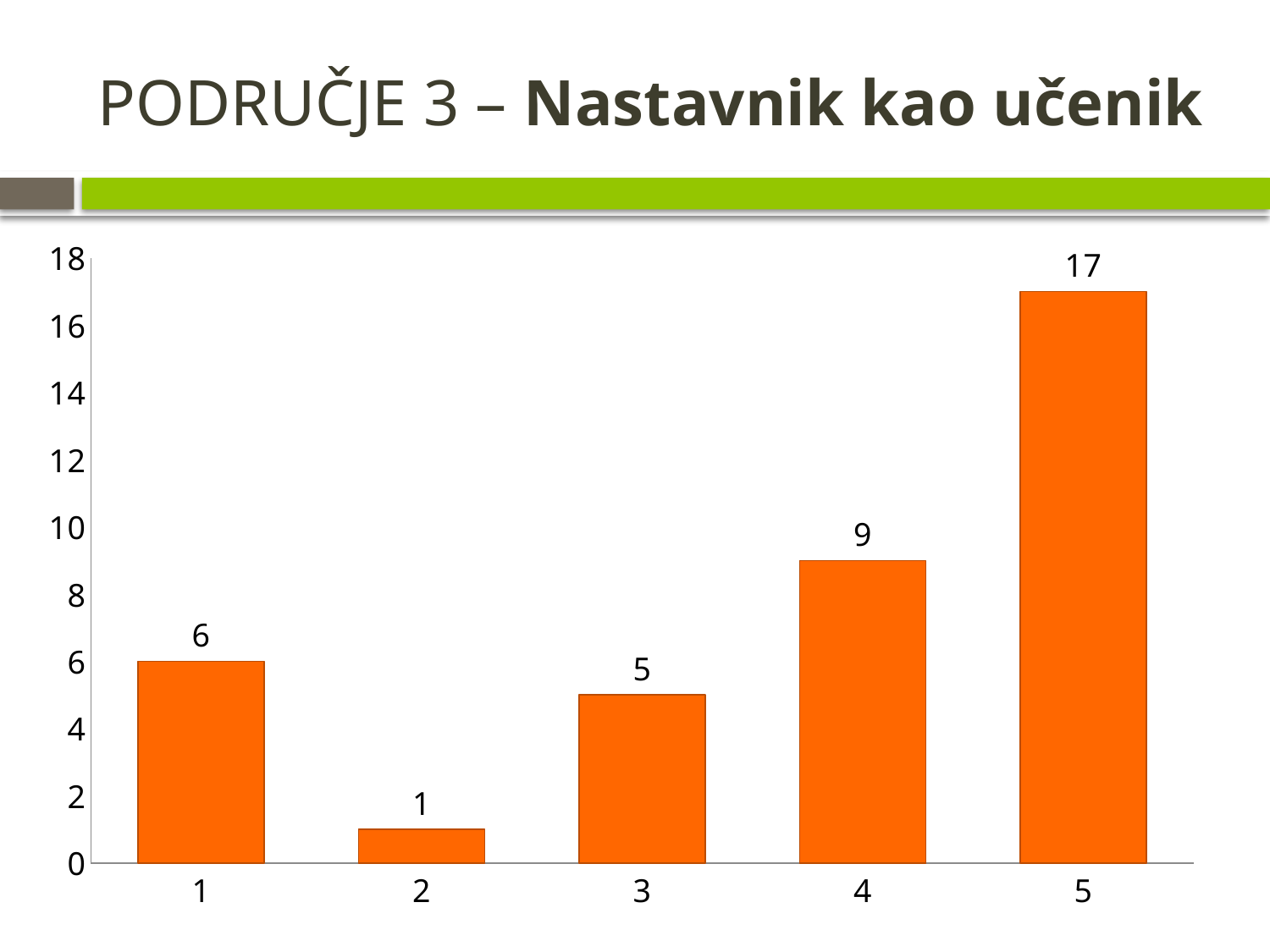
What kind of chart is shown on the slide? bar chart How many categories are shown on the x axis? 5 What is the value for category 1? 6 What is the value for category 3? 5 Is the value for category 4 greater or less than 10? less What is the value for category 5? 17 What is the difference between the values for category 5 and category 4? 8 Which category has the highest value? 5 What is the title of the slide? PODRUČJE 3 – Nastavnik kao učenik Which category has the lowest value? 2 Which is larger, the value for category 1 or the value for category 4? category 4 What is the difference between the values for category 1 and category 3? 1